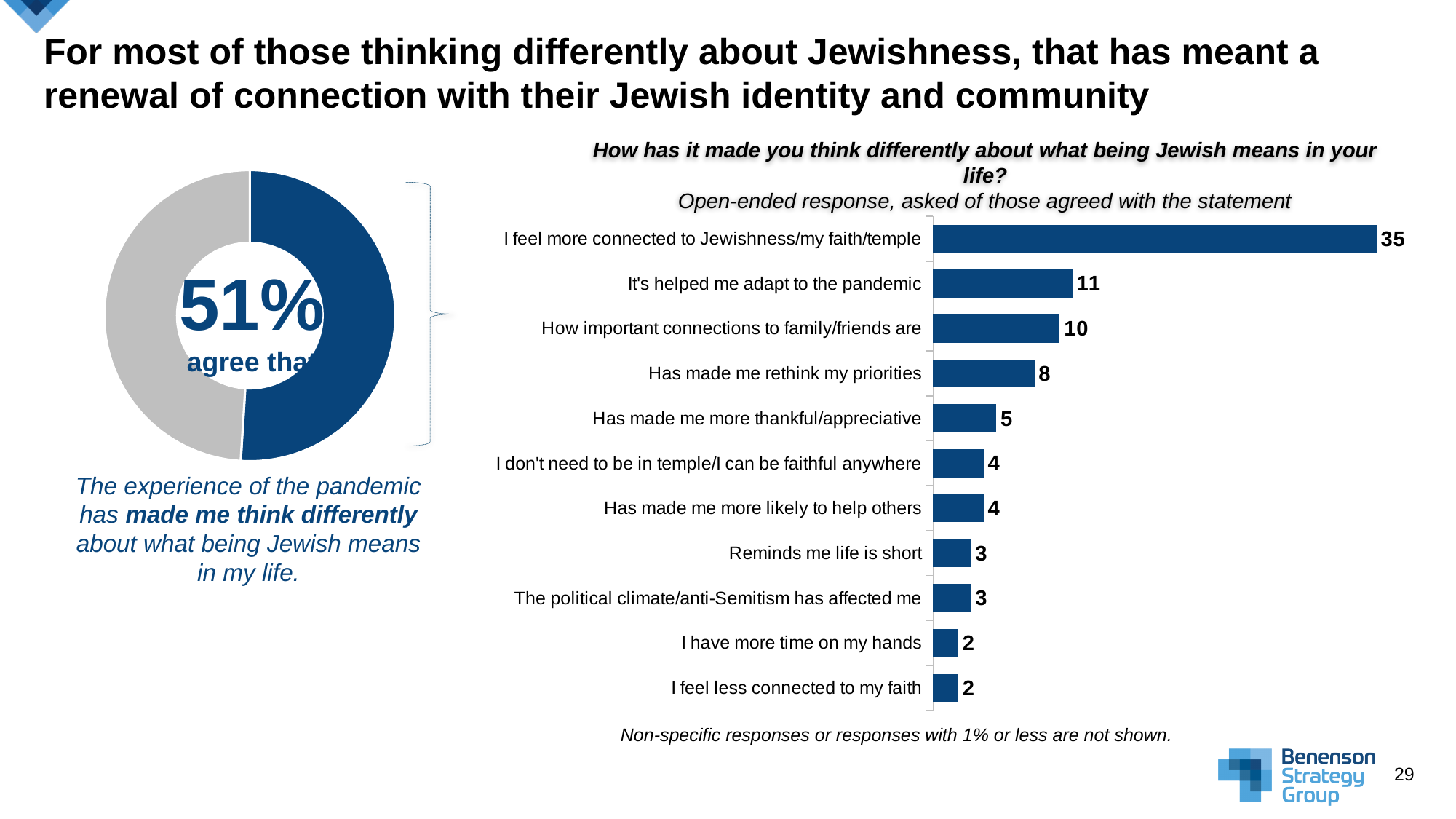
In the doughnut chart on the left, what percentage agree with the statement? 51% In the bar chart on the right, which response has the highest value? I feel more connected to Jewishness/my faith/temple How many response categories are shown in the bar chart on the right? 11 What kind of chart is on the right side of the slide? Bar chart In the bar chart on the right, what is the difference between the highest value and 'Has made me more thankful/appreciative'? 30 In the bar chart on the right, what is the value for 'Has made me rethink my priorities'? 8 What kind of chart is on the left side of the slide? Doughnut chart In the bar chart on the right, what is the value for 'I feel less connected to my faith'? 2 In the bar chart on the right, what is the value for 'It's helped me adapt to the pandemic'? 11 In the bar chart on the right, which is larger: 'Has made me rethink my priorities' or 'Reminds me life is short'? Has made me rethink my priorities In the bar chart on the right, what is the value for 'I feel more connected to Jewishness/my faith/temple'? 35 In the bar chart on the right, what is the difference between 'It's helped me adapt to the pandemic' and 'How important connections to family/friends are'? 1